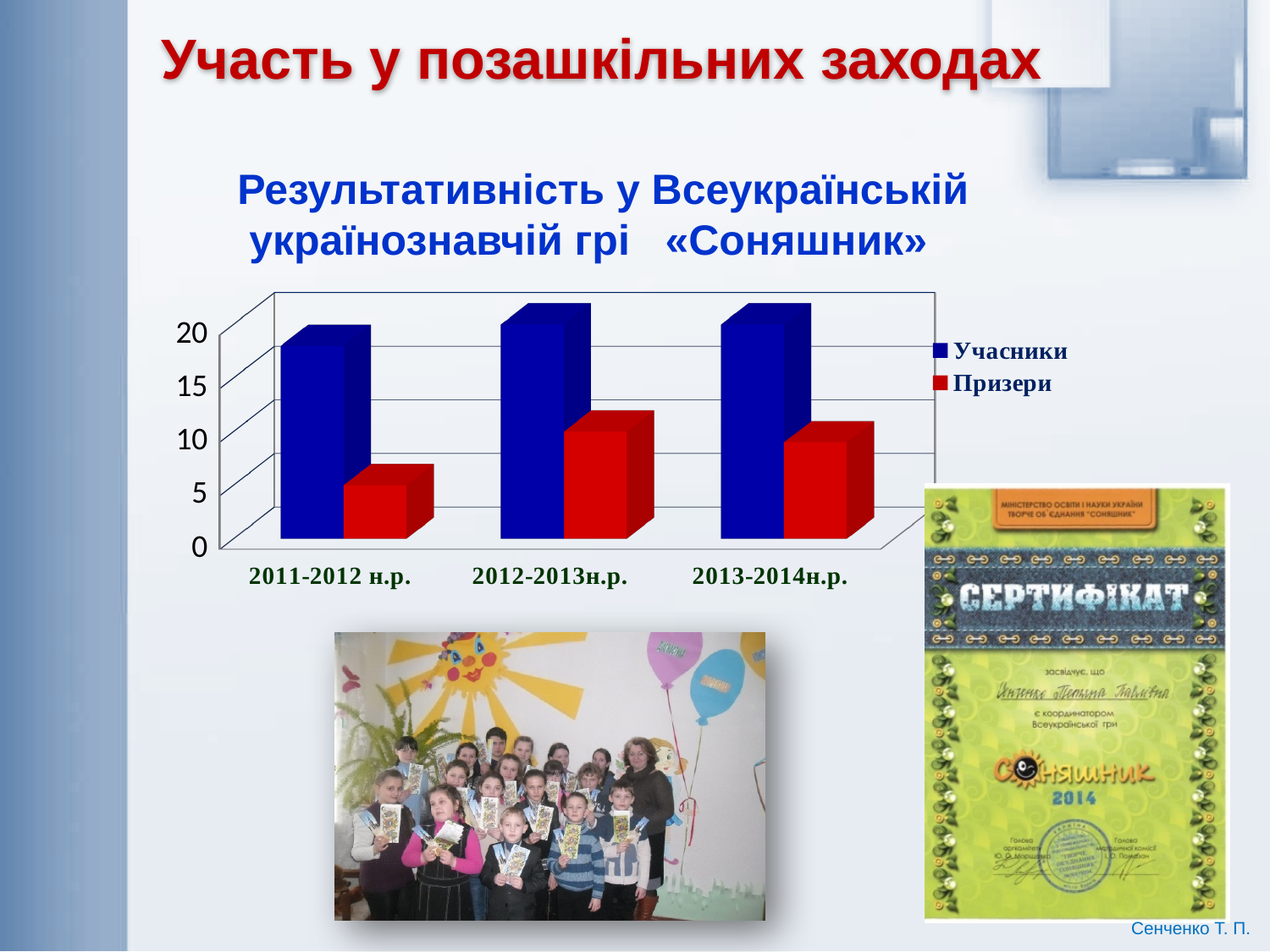
What kind of chart is shown on the slide? bar chart Is the value for Призери in 2012-2013н.р. greater or less than 5? greater In which school year is the Учасники value lowest? 2011-2012 н.р. Which series in the chart is drawn in red? Призери How many series does the chart legend list? 2 In which school year is the Призери value lowest? 2011-2012 н.р. Is the value for Учасники in 2011-2012 н.р. greater or less than 15? greater How many school-year categories are shown on the x axis of the chart? 3 What is the title shown above the chart? Результативність у Всеукраїнській українознавчій грі «Соняшник» Is the value for Учасники in 2013-2014н.р. greater or less than 15? greater In 2011-2012 н.р., which is larger: Учасники or Призери? Учасники